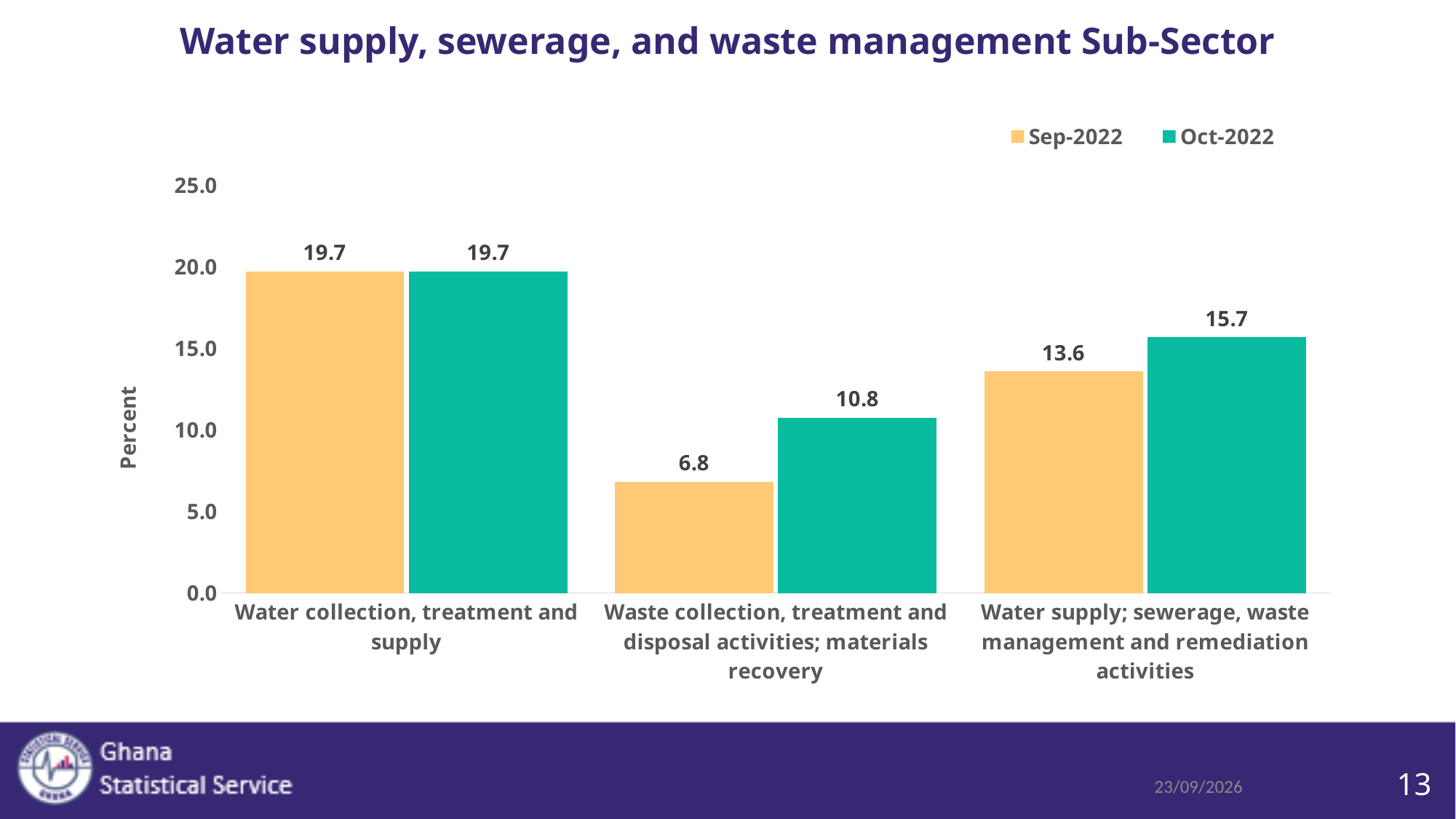
What is the Sep-2022 value for Water supply; sewerage, waste management and remediation activities? 13.6 How many series does the legend list? 2 What is the difference between the Oct-2022 and Sep-2022 values for Water supply; sewerage, waste management and remediation activities? 2.1 Which category has the highest Oct-2022 value? Water collection, treatment and supply What kind of chart is shown on the slide? Bar chart What is the Sep-2022 value for Water collection, treatment and supply? 19.7 What is the Oct-2022 value for Waste collection, treatment and disposal activities; materials recovery? 10.8 Which is larger for Water supply; sewerage, waste management and remediation activities: the Sep-2022 value or the Oct-2022 value? Oct-2022 Which category has the lowest Sep-2022 value? Waste collection, treatment and disposal activities; materials recovery What is the difference between the Oct-2022 and Sep-2022 values for Waste collection, treatment and disposal activities; materials recovery? 4.0 What is the label of the y axis? Percent How many categories are shown on the x axis? 3